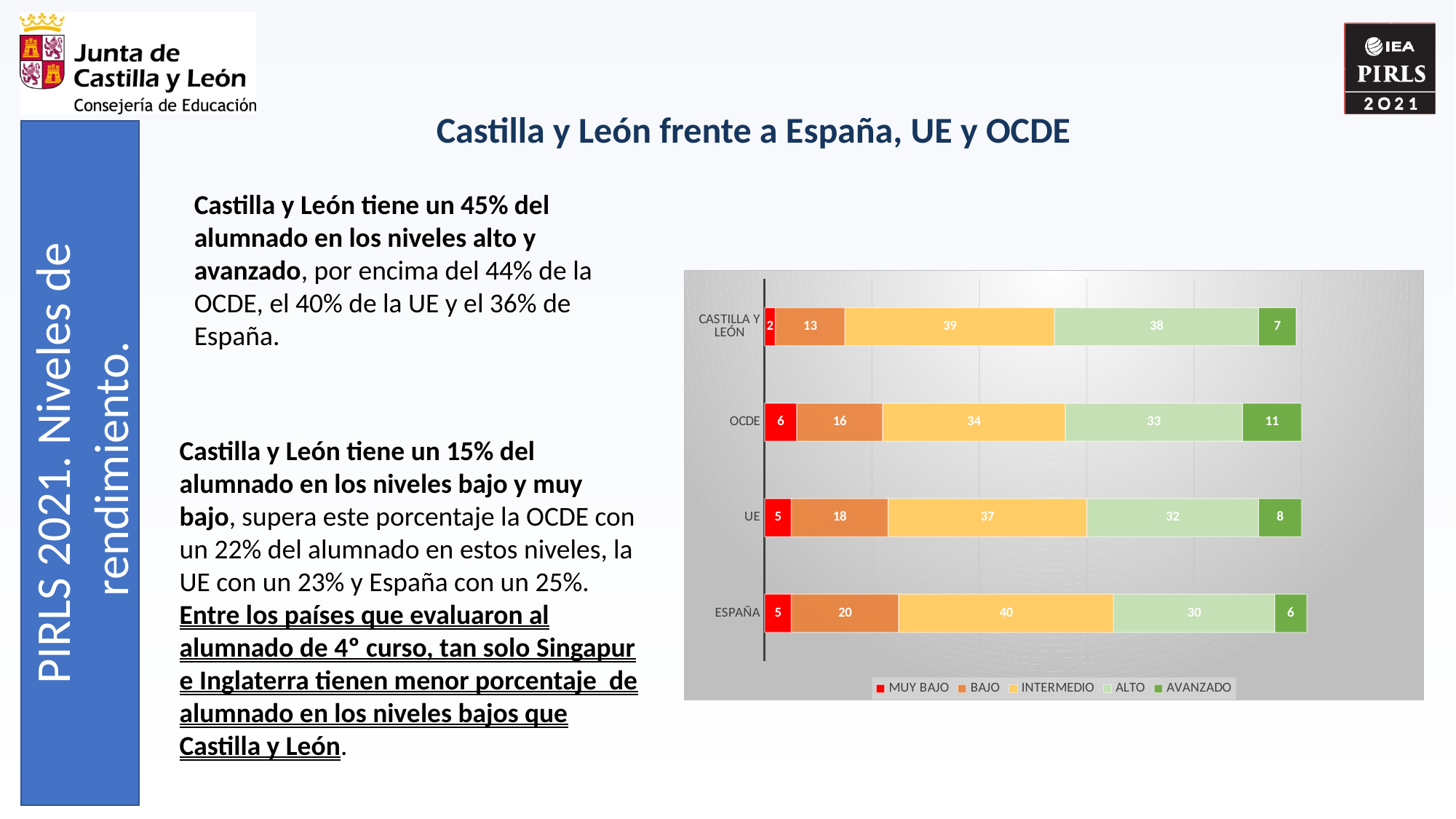
Which series in the legend is shown in red? MUY BAJO What is the INTERMEDIO value for Castilla y León? 39 How many categories (rows) are plotted in the chart? 4 Which category has the highest AVANZADO value? OCDE What is the difference between the ALTO value for Castilla y León and the ALTO value for España? 8 Which is larger, the BAJO value for UE or the BAJO value for OCDE? UE How many series does the chart legend list? 5 What is the total of the stacked bar for UE? 100 Which category has the lowest MUY BAJO value? Castilla y León What is the BAJO value for España? 20 What is the AVANZADO value for OCDE? 11 What kind of chart is shown on the slide? Stacked bar chart